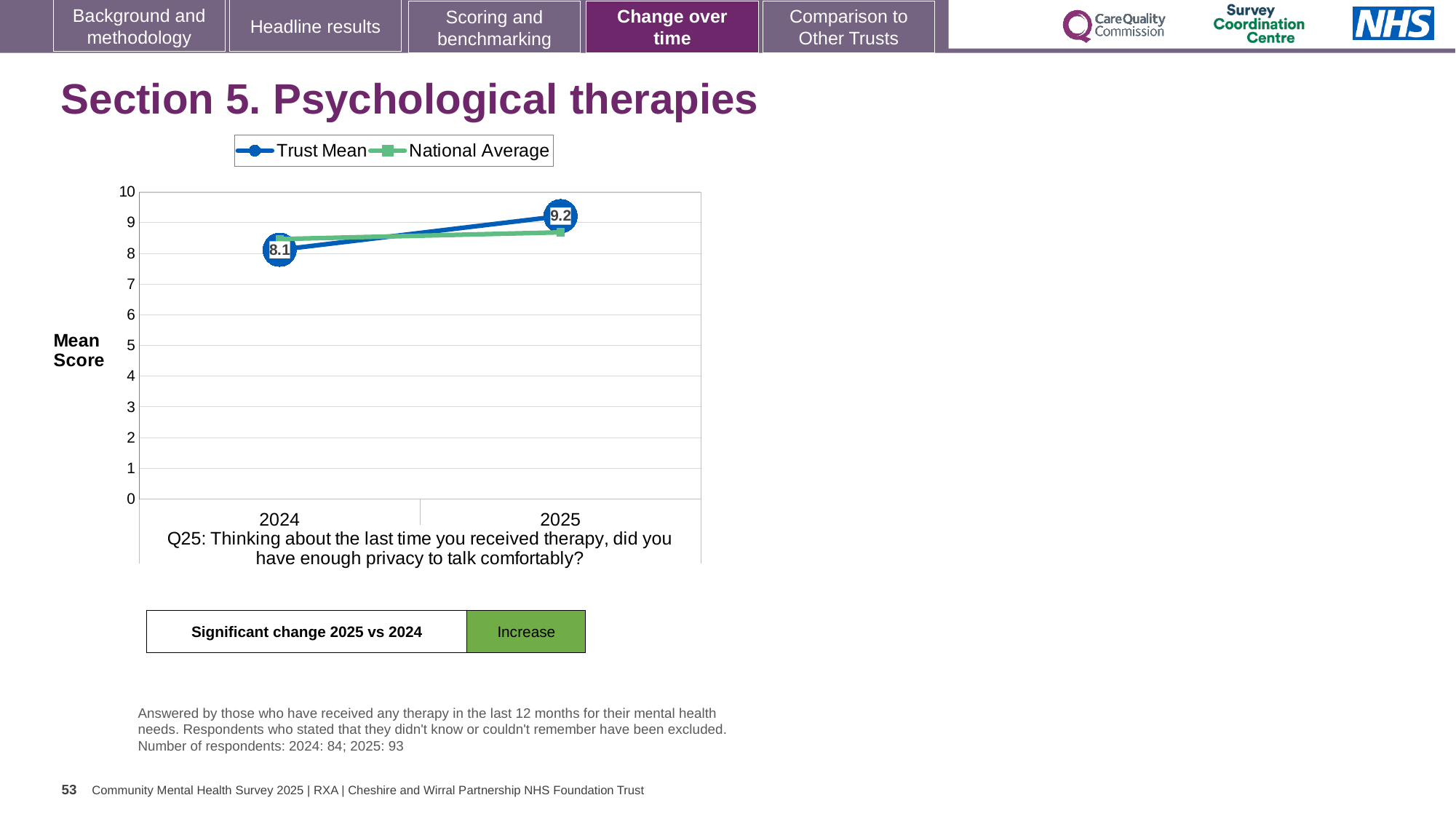
What is the Trust Mean score for 2025? 9.2 Is the National Average value for 2025 greater or less than 9? less In 2025, which is higher, the Trust Mean or the National Average? Trust Mean How many years are plotted on the x axis? 2 What is the label on the y axis of the chart? Mean Score What kind of chart is shown on the slide? line chart Is the National Average value for 2024 greater or less than 8? greater How many series does the legend list? 2 Does the Trust Mean rise or fall from 2024 to 2025? rise What is the Trust Mean score for 2024? 8.1 By how much did the Trust Mean change from 2024 to 2025? 1.1 Which year has the higher Trust Mean, 2024 or 2025? 2025